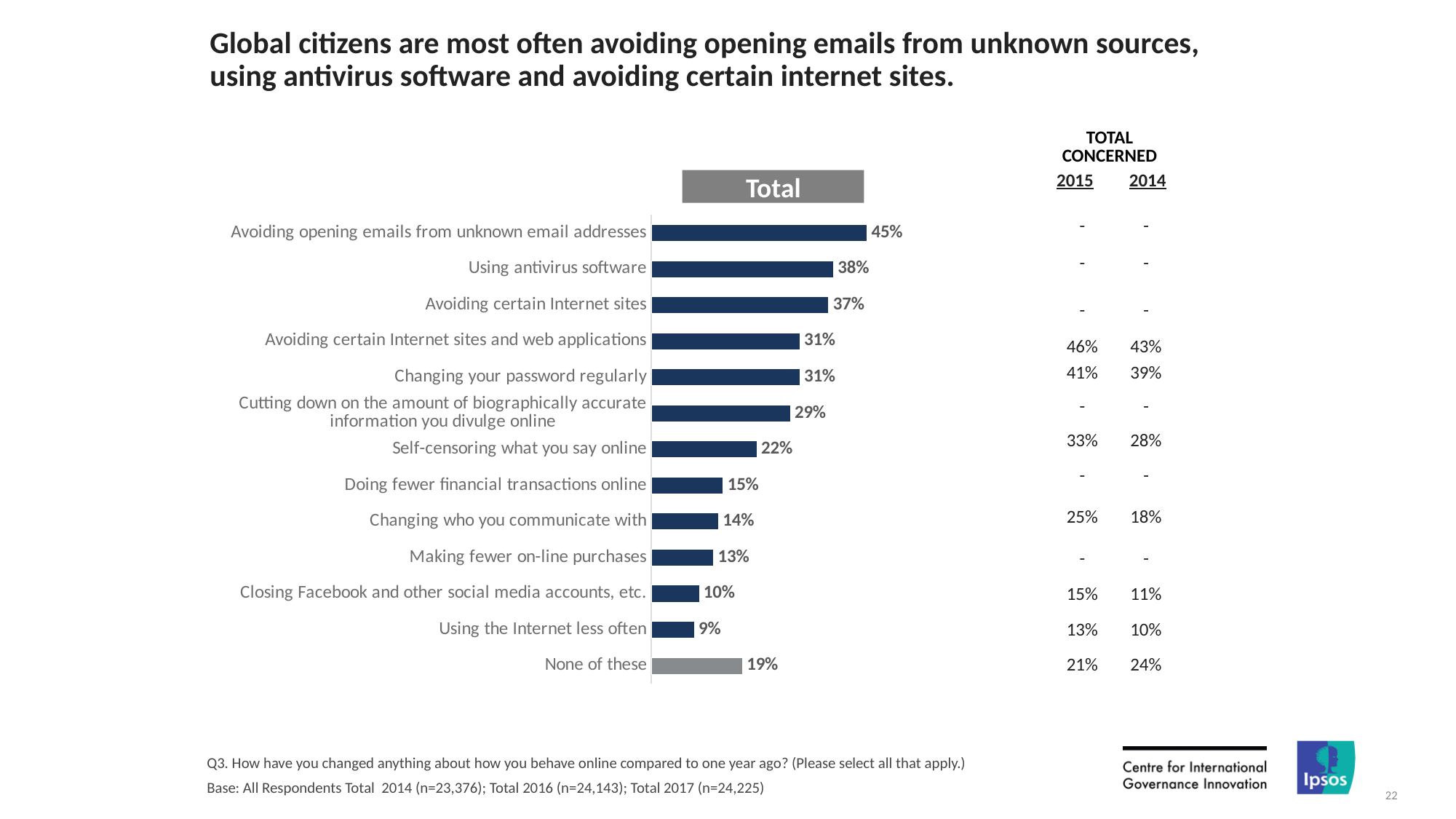
Which category has the highest value? Avoiding opening emails from unknown email addresses How many categories are shown in the chart? 13 What kind of chart is shown on the slide? Bar chart What is the value for "Using antivirus software"? 38% What is the value for "Self-censoring what you say online"? 22% What is the difference between "Doing fewer financial transactions online" and "Using the Internet less often"? 6% Which is larger: "Cutting down on the amount of biographically accurate information you divulge online" or "Self-censoring what you say online"? Cutting down on the amount of biographically accurate information you divulge online What is the label shown in the grey header box above the bars? Total Which is larger: "Changing who you communicate with" or "Making fewer on-line purchases"? Changing who you communicate with What is the difference between "Avoiding opening emails from unknown email addresses" and "Using antivirus software"? 7% Which category has the lowest value? Using the Internet less often What is the value for "None of these"? 19%